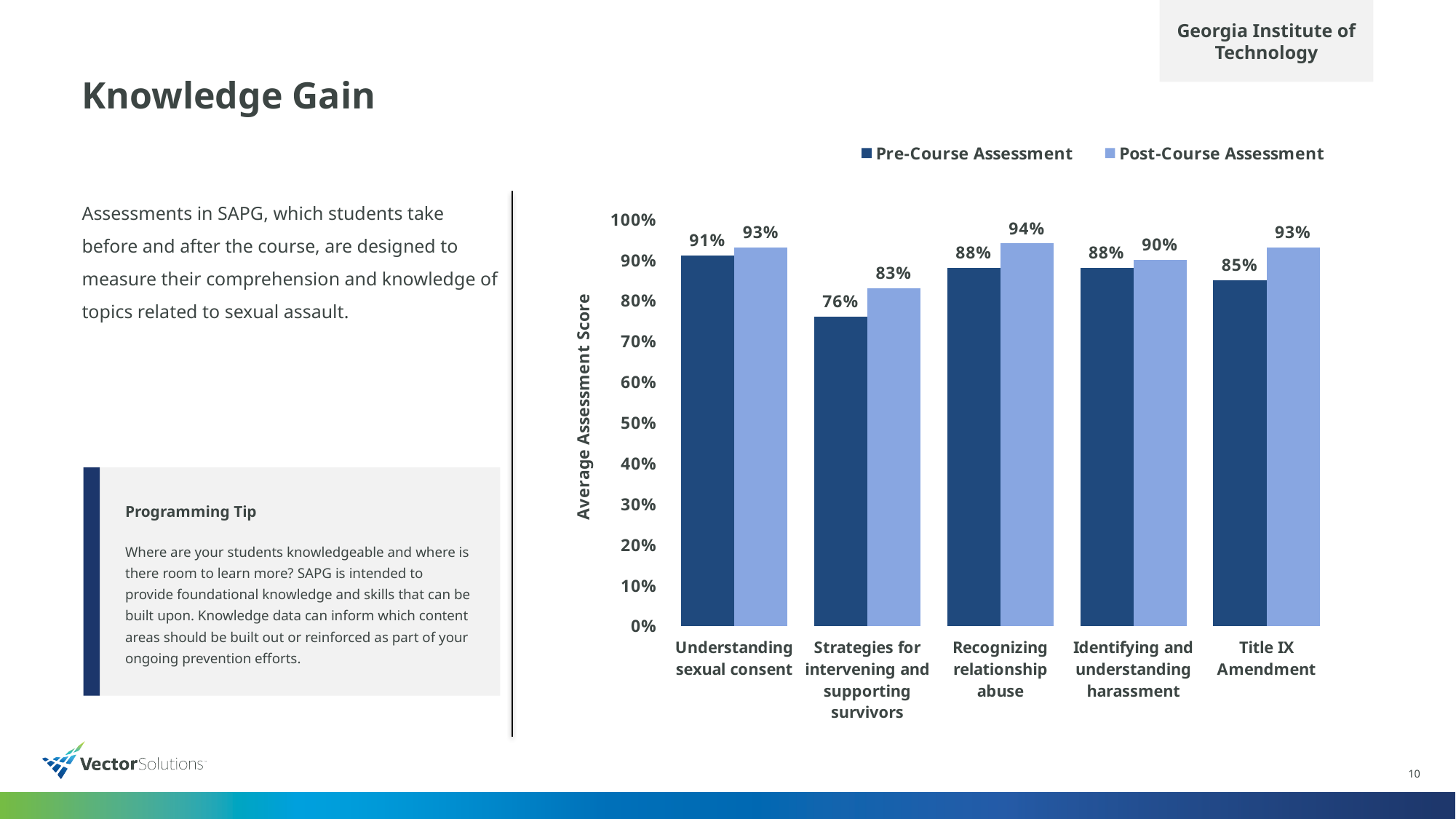
What is the Post-Course Assessment value for Recognizing relationship abuse? 94% How many series does the chart legend list? 2 What is the difference between the Post-Course and Pre-Course Assessment values for Strategies for intervening and supporting survivors? 7% What is the Pre-Course Assessment value for Understanding sexual consent? 91% What type of chart is shown on the slide? Bar chart What is the Post-Course Assessment value for Strategies for intervening and supporting survivors? 83% Which is larger: the Pre-Course Assessment value for Identifying and understanding harassment or the Pre-Course Assessment value for Title IX Amendment? Identifying and understanding harassment Which category has the lowest Pre-Course Assessment value? Strategies for intervening and supporting survivors Which category has the highest Post-Course Assessment value? Recognizing relationship abuse What is the difference between the Post-Course and Pre-Course Assessment values for Title IX Amendment? 8% What is the Pre-Course Assessment value for Title IX Amendment? 85% How many categories are shown on the x axis of the chart? 5